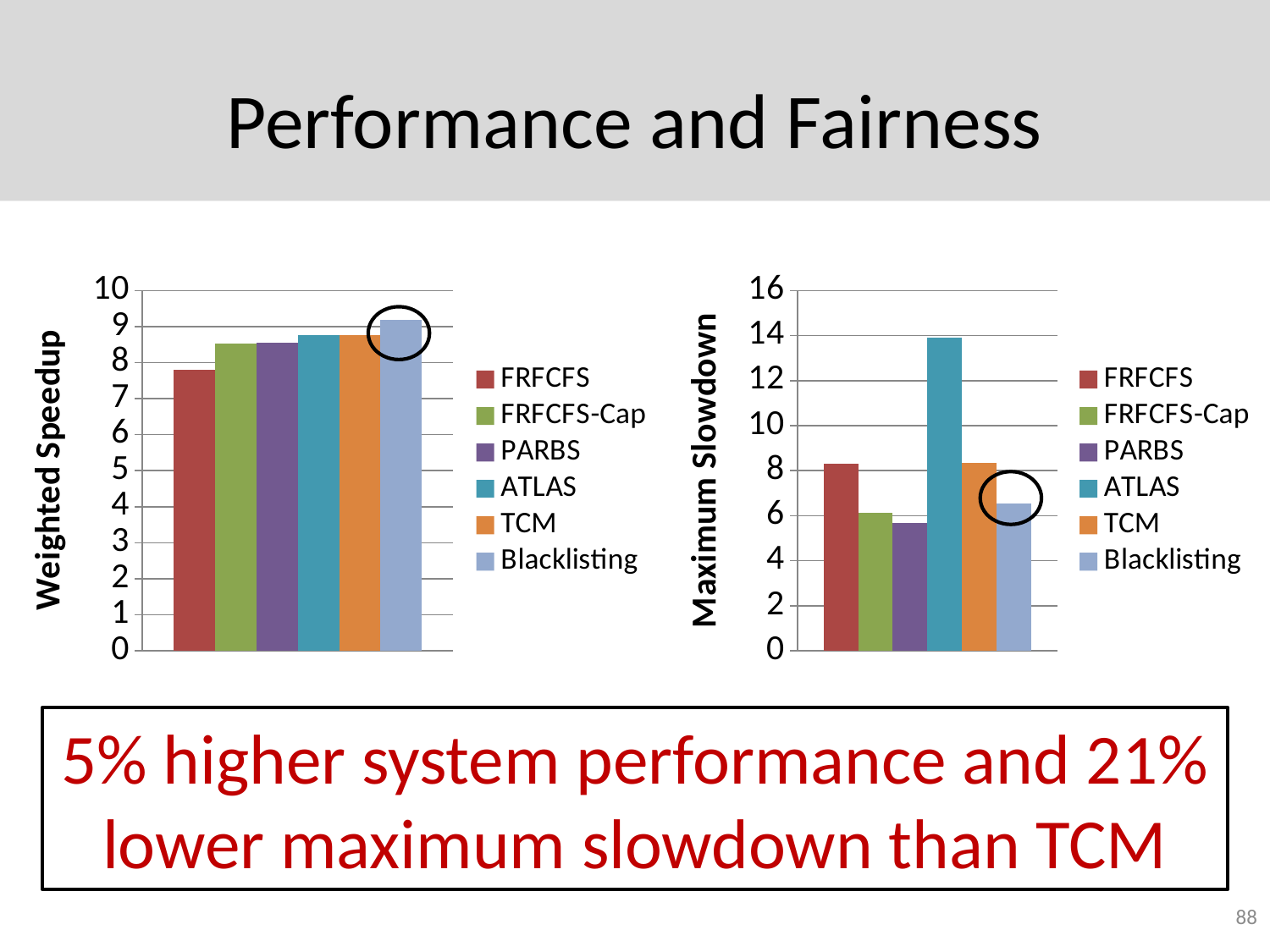
What is the y-axis title of the left chart? Weighted Speedup What kind of chart is the Maximum Slowdown chart (right)? bar chart In the Weighted Speedup chart (left), which series has the highest value? Blacklisting In the Maximum Slowdown chart (right), which is larger, the value for ATLAS or the value for TCM? ATLAS In the Weighted Speedup chart (left), is the value for Blacklisting greater or less than 9? greater In the Maximum Slowdown chart (right), which series has the highest value? ATLAS In the Weighted Speedup chart (left), which series has the lowest value? FRFCFS In the Maximum Slowdown chart (right), which is larger, the value for FRFCFS or the value for Blacklisting? FRFCFS In the Weighted Speedup chart (left), is the value for FRFCFS greater or less than 8? less In the Maximum Slowdown chart (right), is the value for ATLAS greater or less than 12? greater In the Weighted Speedup chart (left), how many series does the legend list? 6